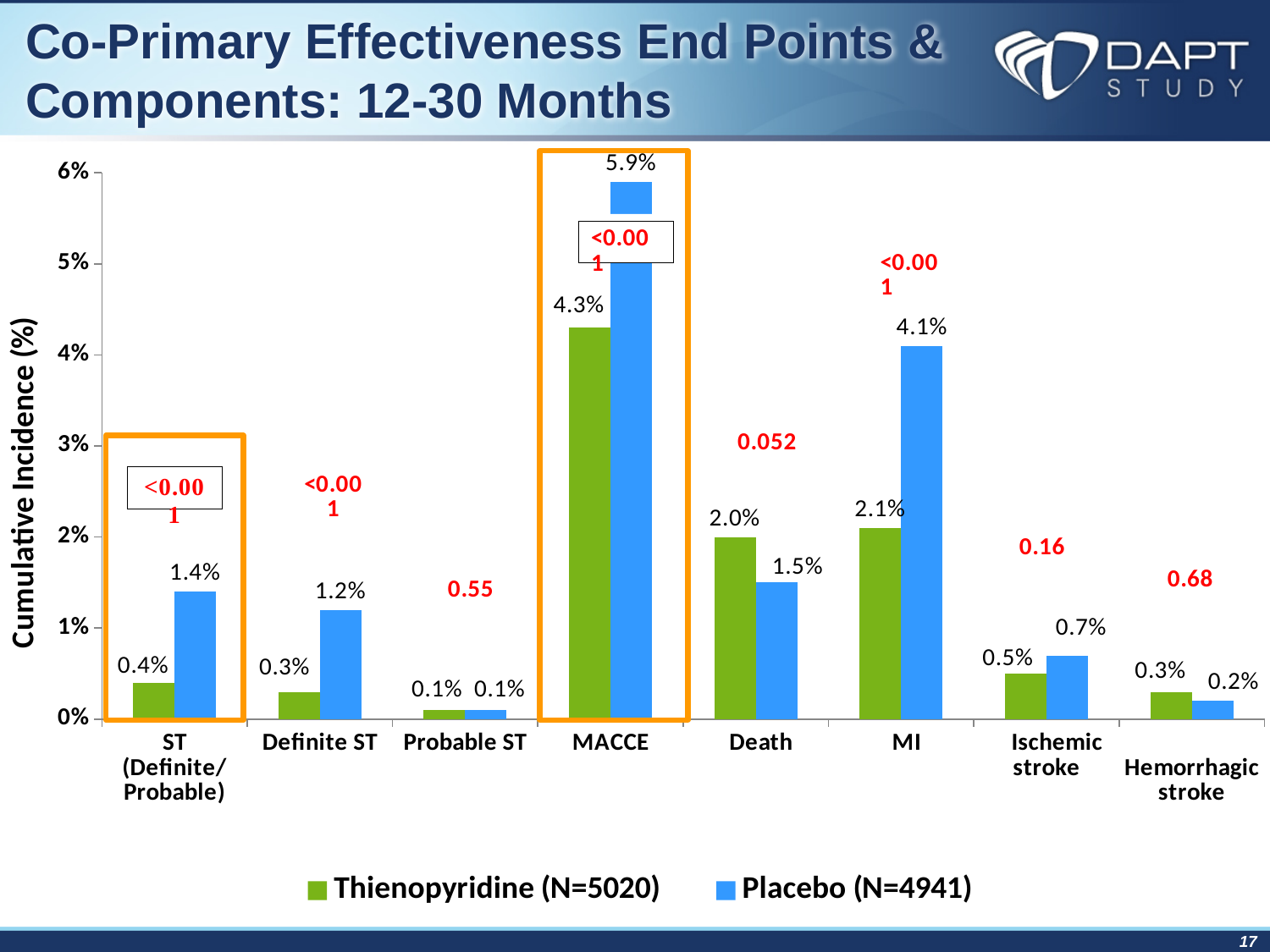
What is the difference between the Placebo and Thienopyridine values for ST (Definite/Probable)? 1.0% What kind of chart is shown on the slide? Bar chart For Death, which group has the higher cumulative incidence, Thienopyridine or Placebo? Thienopyridine For Hemorrhagic stroke, which group has the higher cumulative incidence, Thienopyridine or Placebo? Thienopyridine Which category has the highest cumulative incidence for the Placebo group? MACCE How many series does the legend list? 2 What is the cumulative incidence of Death for the Placebo group? 1.5% What is the cumulative incidence of MACCE for the Placebo group? 5.9% What is the difference between the Placebo and Thienopyridine values for MI? 2.0% What is the cumulative incidence of MI for the Thienopyridine group? 2.1% Which category has the lowest cumulative incidence for the Thienopyridine group? Probable ST How many categories are shown on the x axis? 8